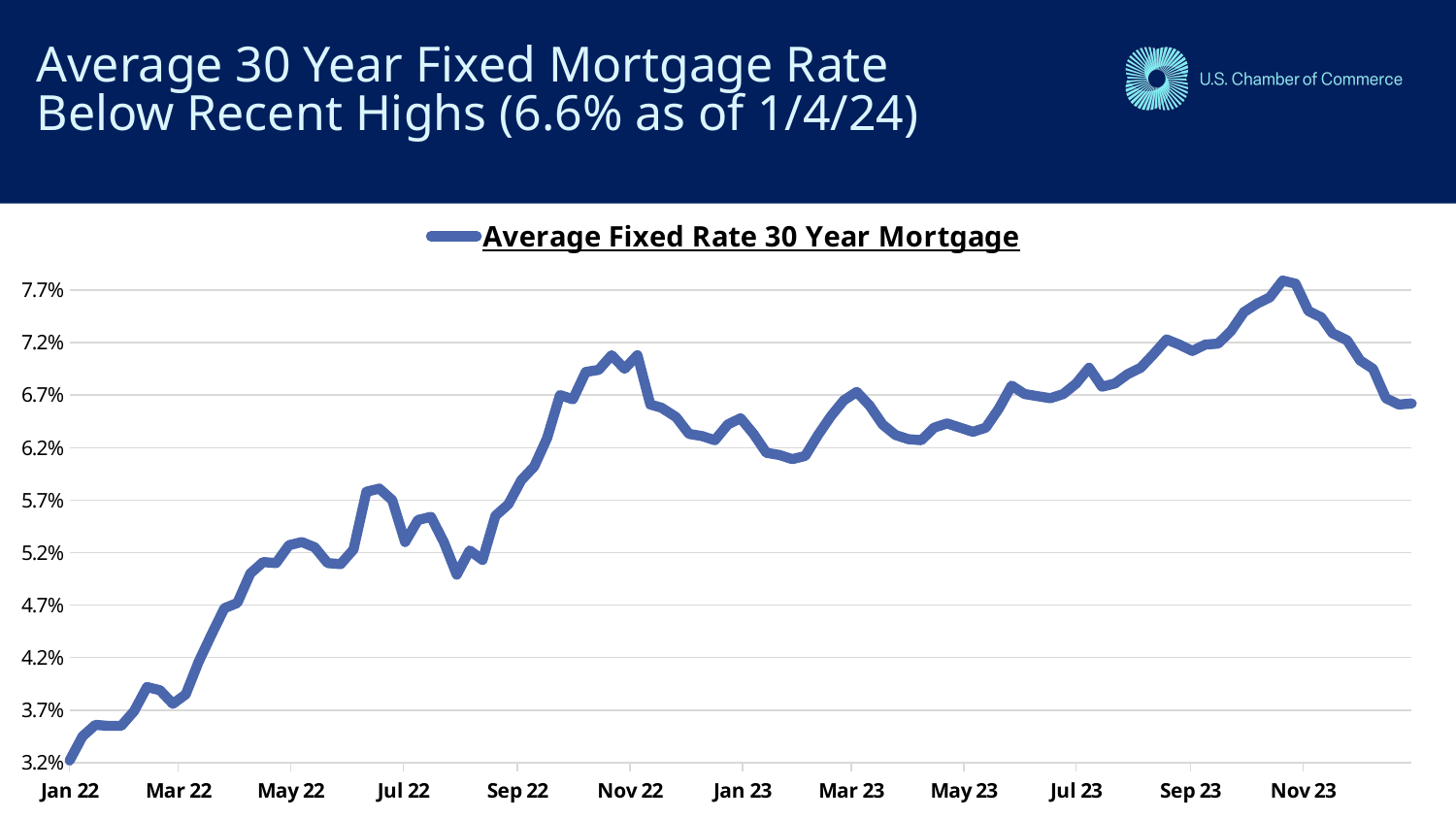
Is the mortgage rate at Jan 22 greater or less than 3.7%? less Is the mortgage rate at May 22 greater or less than 4.7%? greater Which is higher, the mortgage rate at Nov 22 or at Nov 23? Nov 23 What kind of chart is shown on the slide? line chart Does the mortgage rate rise or fall from Jan 22 to Nov 22? rise Is the mortgage rate at Nov 22 greater or less than 6.7%? greater What is the legend entry for the plotted series? Average Fixed Rate 30 Year Mortgage According to the slide title, what is the average 30 year fixed mortgage rate as of 1/4/24? 6.6% Around which month label does the mortgage rate reach its highest point? Nov 23 How many series does the legend list? 1 At which month label is the mortgage rate lowest? Jan 22